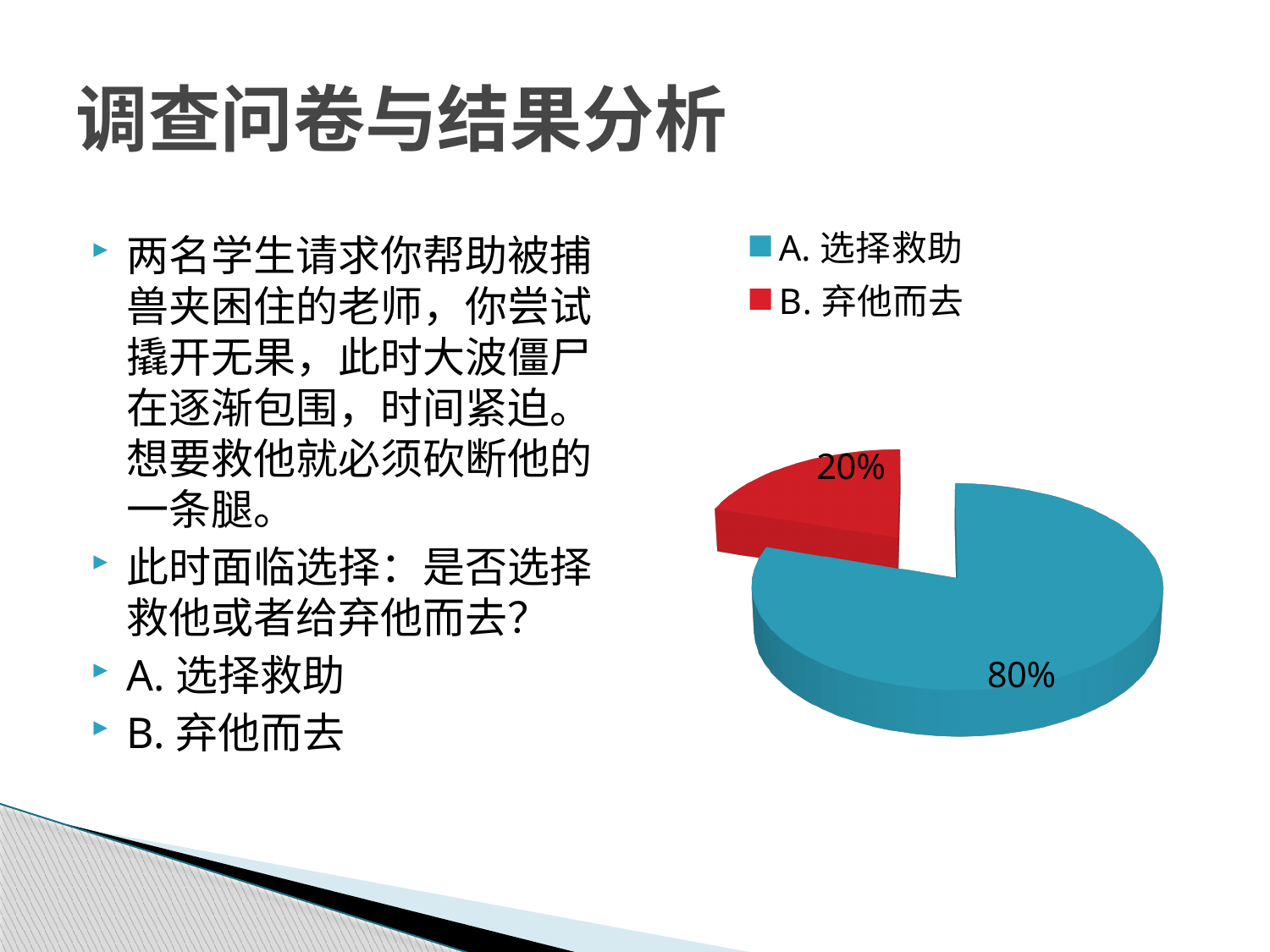
Which slice of the pie is the largest? A. 选择救助 What kind of chart is shown on the slide? pie chart How many entries does the legend list? 2 What share of the pie does "A. 选择救助" take? 80% Which slice of the pie is the smallest? B. 弃他而去 How many slices does the pie chart have? 2 What is the difference in percentage points between the "A. 选择救助" slice and the "B. 弃他而去" slice? 60 Which is larger, the share for "A. 选择救助" or the share for "B. 弃他而去"? A. 选择救助 What colour is the slice for "A. 选择救助"? blue What share of the pie does "B. 弃他而去" take? 20% What colour is the slice for "B. 弃他而去"? red